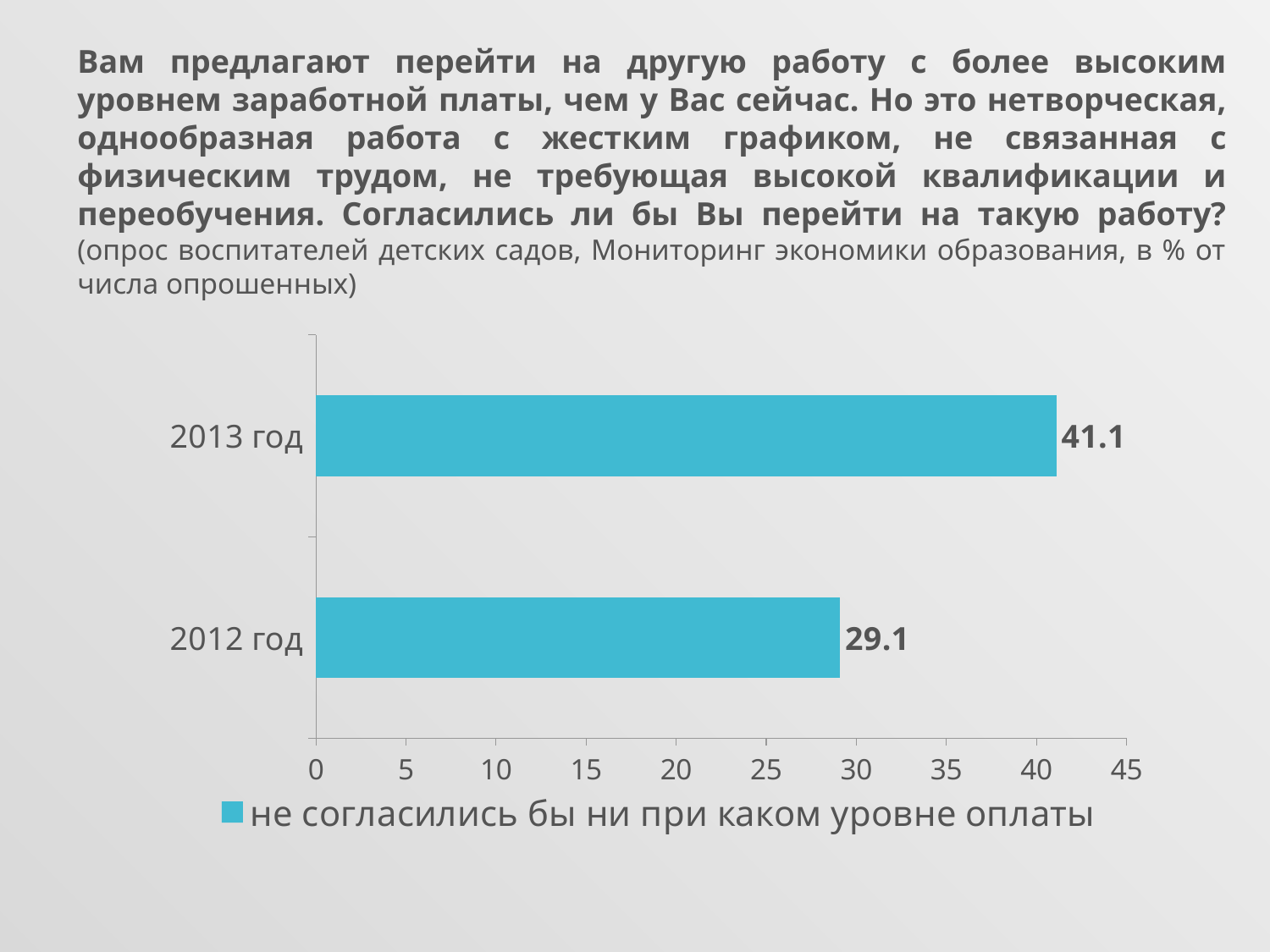
Is the value for 2012 год greater or less than 30? less What is the value for 2012 год? 29.1 How many series does the legend list? 1 What is the value for 2013 год? 41.1 Is the value for 2012 год larger or smaller than the value for 2013 год? smaller What is the difference between the values for 2013 год and 2012 год? 12.0 Which year has the higher value? 2013 год How many categories are shown on the chart? 2 Which year has the lower value? 2012 год What is the legend entry for the series shown on the chart? не согласились бы ни при каком уровне оплаты What kind of chart is shown on the slide? bar chart Is the value for 2013 год greater or less than 40? greater